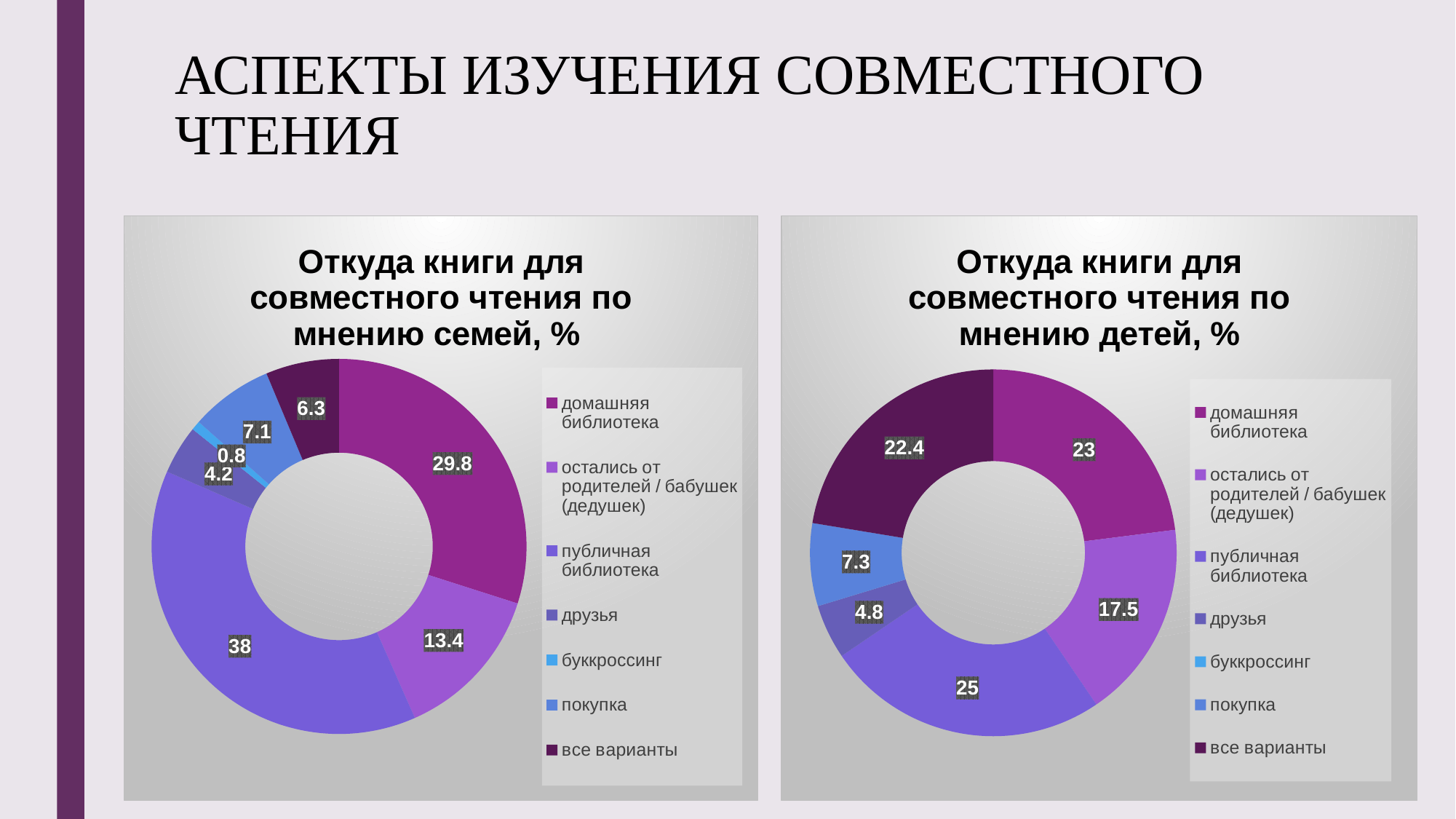
In the chart 'Откуда книги для совместного чтения по мнению семей, %', what is the difference between публичная библиотека and домашняя библиотека? 8.2 In the chart 'Откуда книги для совместного чтения по мнению семей, %', what is the value for публичная библиотека? 38 In the chart 'Откуда книги для совместного чтения по мнению семей, %', what is the value for буккроссинг? 0.8 In the chart 'Откуда книги для совместного чтения по мнению детей, %', what is the value for остались от родителей / бабушек (дедушек)? 17.5 In the chart 'Откуда книги для совместного чтения по мнению детей, %', what is the difference between домашняя библиотека and покупка? 15.7 In the chart 'Откуда книги для совместного чтения по мнению детей, %', what is the value for все варианты? 22.4 In the chart 'Откуда книги для совместного чтения по мнению детей, %', which labelled category has the largest value? публичная библиотека In the chart 'Откуда книги для совместного чтения по мнению семей, %', which category has the largest value? публичная библиотека Which is larger: все варианты in the chart by families (семей) or все варианты in the chart by children (детей)? the chart by children (детей) What kind of chart is 'Откуда книги для совместного чтения по мнению детей, %'? doughnut (pie) chart In the chart 'Откуда книги для совместного чтения по мнению семей, %', which category has the smallest value? буккроссинг How many entries does the legend of the chart 'Откуда книги для совместного чтения по мнению семей, %' list? 7